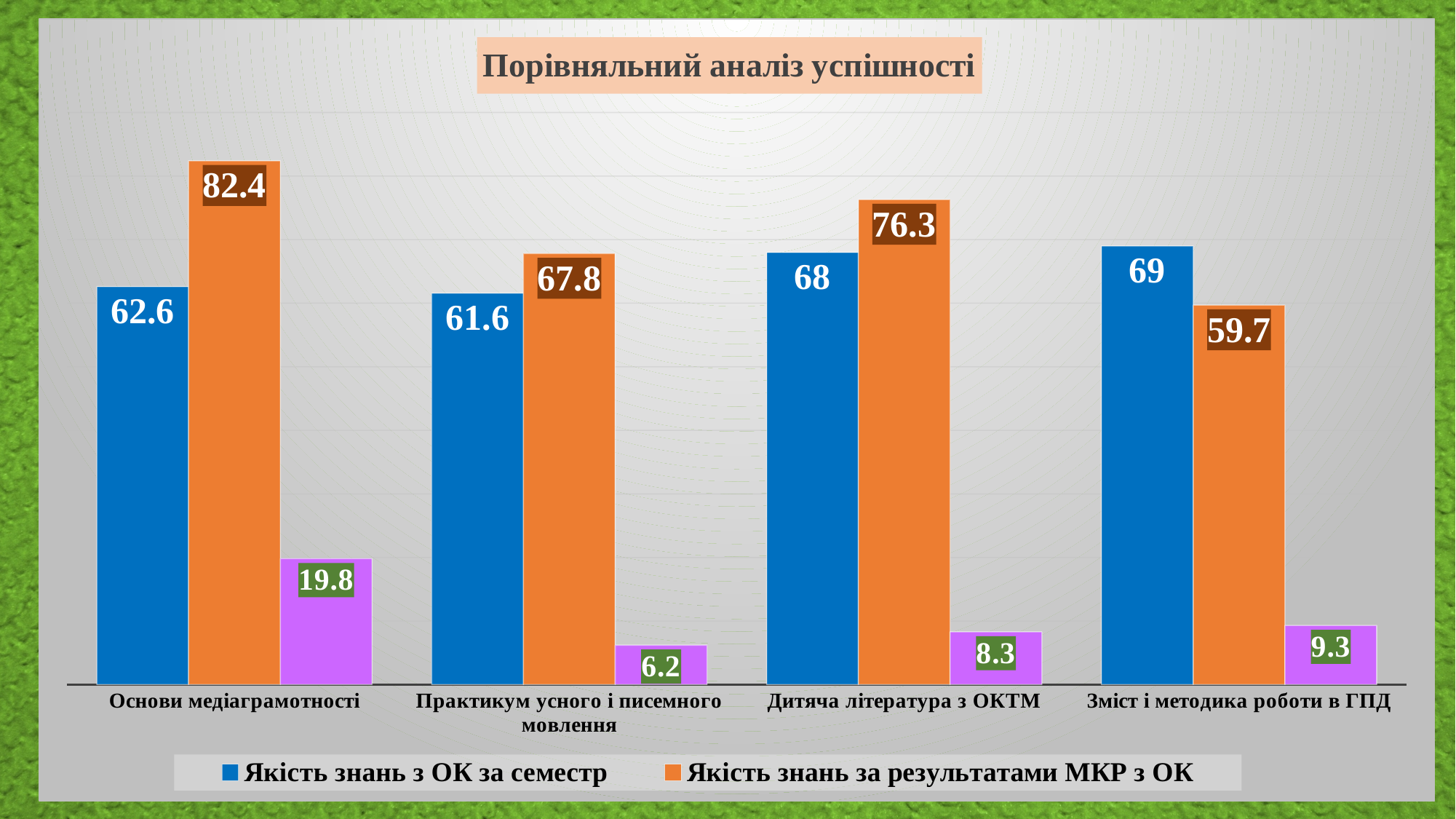
What is the value of "Якість знань за результатами МКР з ОК" for "Зміст і методика роботи в ГПД"? 59.7 What is the value of "Якість знань за результатами МКР з ОК" for "Дитяча література з ОКТМ"? 76.3 What kind of chart is shown on the slide? Bar chart What is the difference between "Якість знань за результатами МКР з ОК" and "Якість знань з ОК за семестр" for "Основи медіаграмотності"? 19.8 What is the value of the purple bar for "Практикум усного і писемного мовлення"? 6.2 Which category has the lowest value for "Якість знань з ОК за семестр"? Практикум усного і писемного мовлення For "Зміст і методика роботи в ГПД", which is larger: "Якість знань з ОК за семестр" or "Якість знань за результатами МКР з ОК"? Якість знань з ОК за семестр Which category has the highest value for "Якість знань за результатами МКР з ОК"? Основи медіаграмотності How many categories are shown on the x axis? 4 What is the value of "Якість знань з ОК за семестр" for "Основи медіаграмотності"? 62.6 What is the title of the chart? Порівняльний аналіз успішності How many series does the legend list? 2